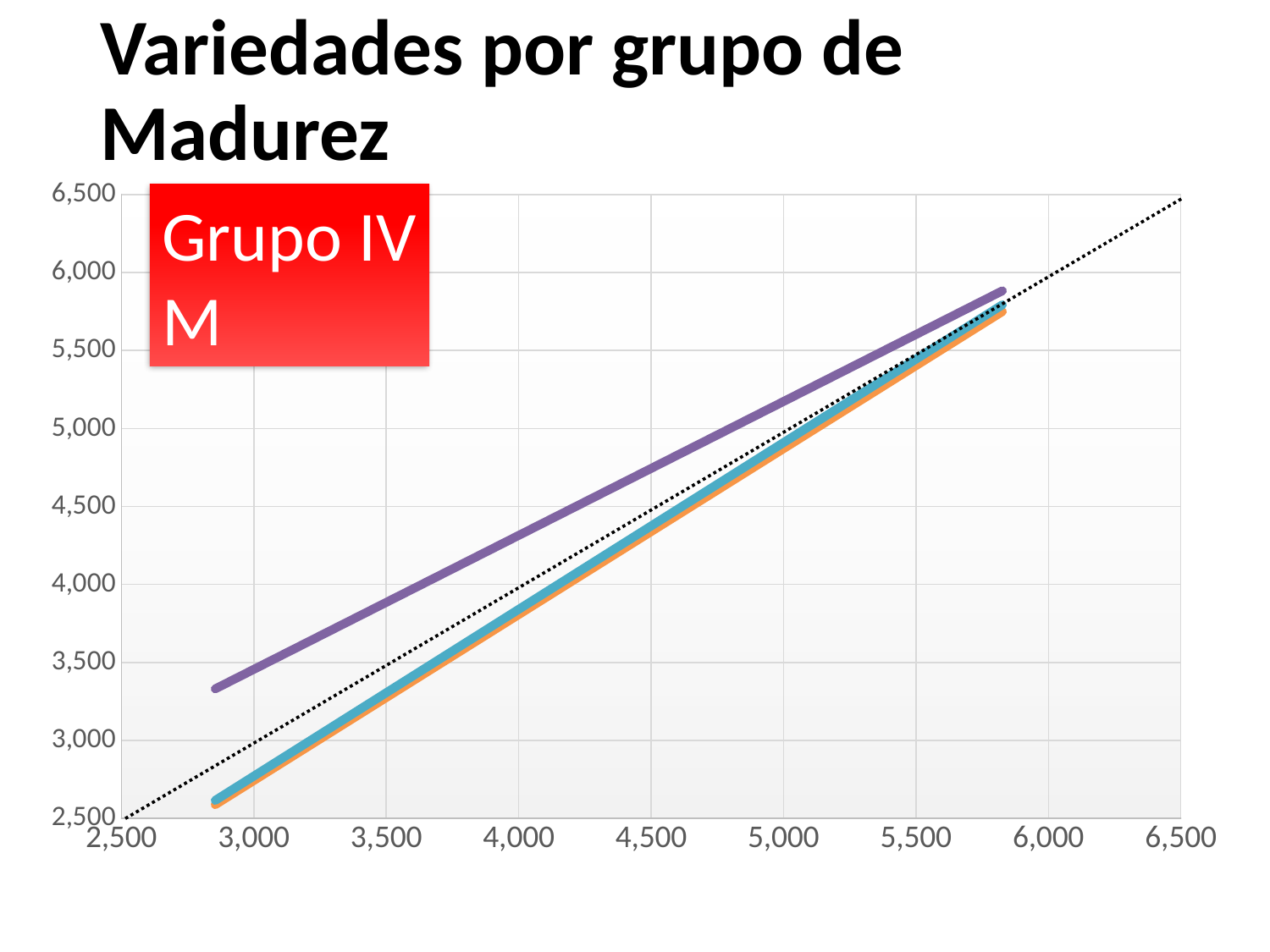
Which coloured line has the highest values across the chart? purple What is the highest value shown on the y-axis? 6,500 Do the plotted lines rise or fall as the x-axis values increase? rise What text appears in the red box on the chart? Grupo IV M How many solid coloured lines are plotted on the chart (excluding the dotted reference line)? 3 What is the lowest value shown on the x-axis? 2,500 What is the title of the chart on the slide? Variedades por grupo de Madurez What kind of chart is shown on the slide? line chart At an x-axis value of 4,000, is the purple line greater or less than 4,000 on the y-axis? greater At an x-axis value of 3,000, is the teal line greater or less than 3,000 on the y-axis? less Is the purple line above or below the dotted diagonal line? above At an x-axis value of 3,000, is the purple line greater or less than 3,000 on the y-axis? greater